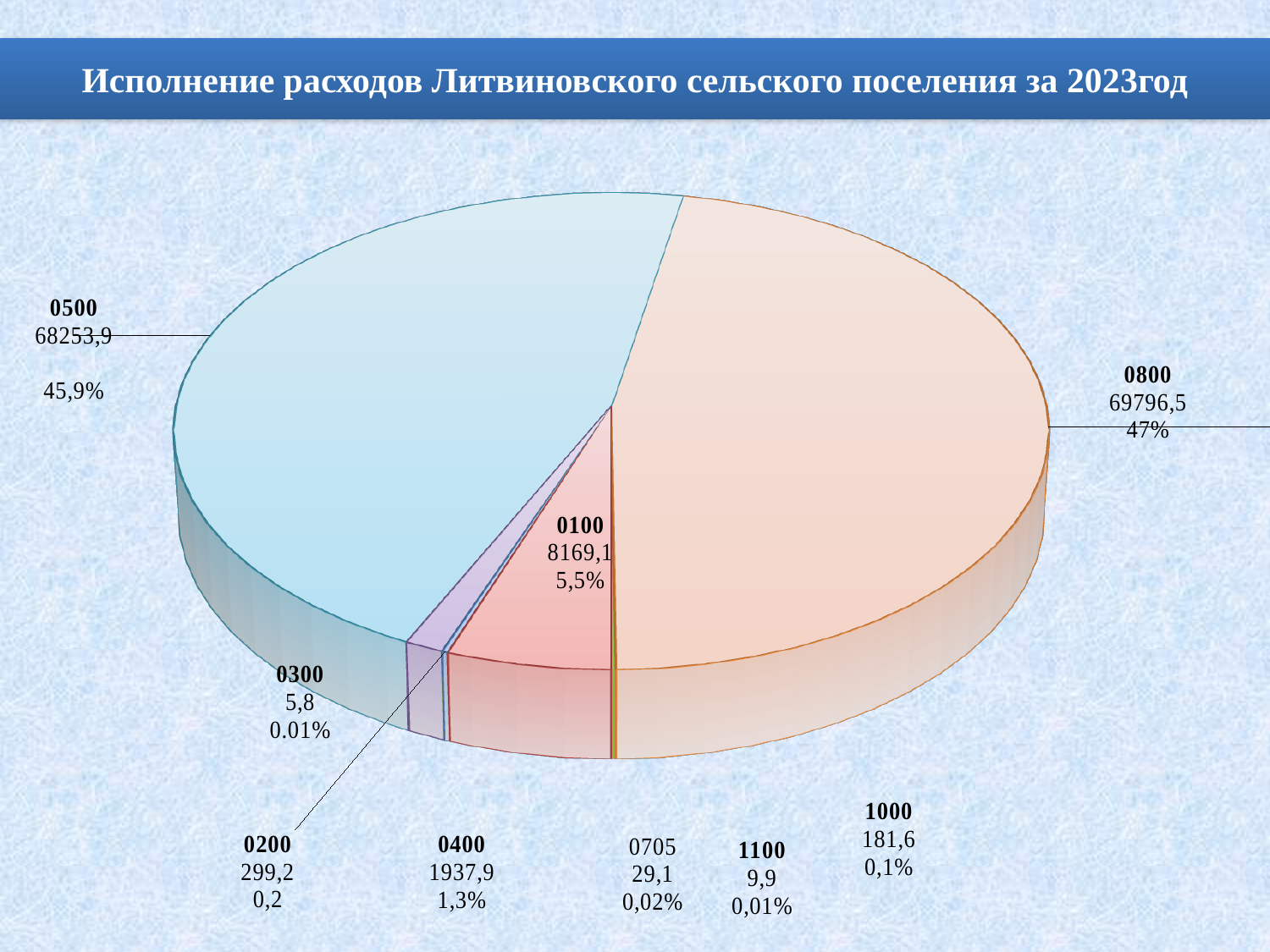
What is the value shown for category 0800? 69796,5 Which category has the largest value? 0800 How many categories are shown in the pie chart? 9 What is the value shown for category 0500? 68253,9 Which category has the smallest value? 0300 Which is larger, the value for 0200 or the value for 1000? 0200 What is the difference between the values for 0800 and 0500? 1542,6 What share of the pie does category 0800 represent? 47% What is the value shown for category 1000? 181,6 What kind of chart is shown on the slide? pie chart What is the value shown for category 0100? 8169,1 What is the value shown for category 0400? 1937,9